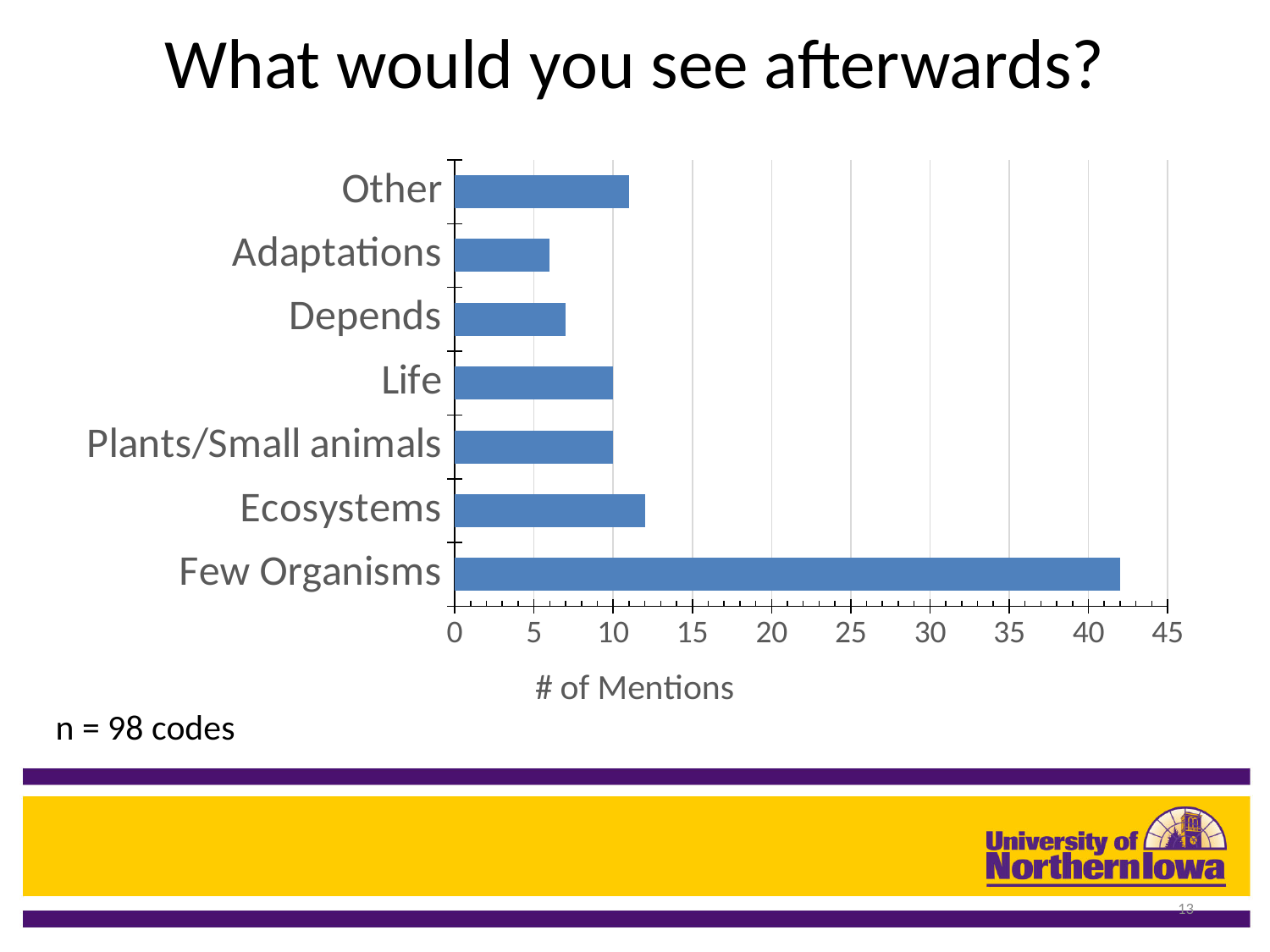
Is the value for Ecosystems greater or less than 10? greater Is the value for Depends greater or less than 10? less Is the value for Few Organisms greater or less than 45? less Which has more mentions, Ecosystems or Adaptations? Ecosystems What is the title of the slide containing the chart? What would you see afterwards? Which category has the highest number of mentions? Few Organisms How many categories are plotted in the chart? 7 What kind of chart is shown on the slide? bar chart What is the label on the horizontal axis of the chart? # of Mentions Which has more mentions, Few Organisms or Ecosystems? Few Organisms